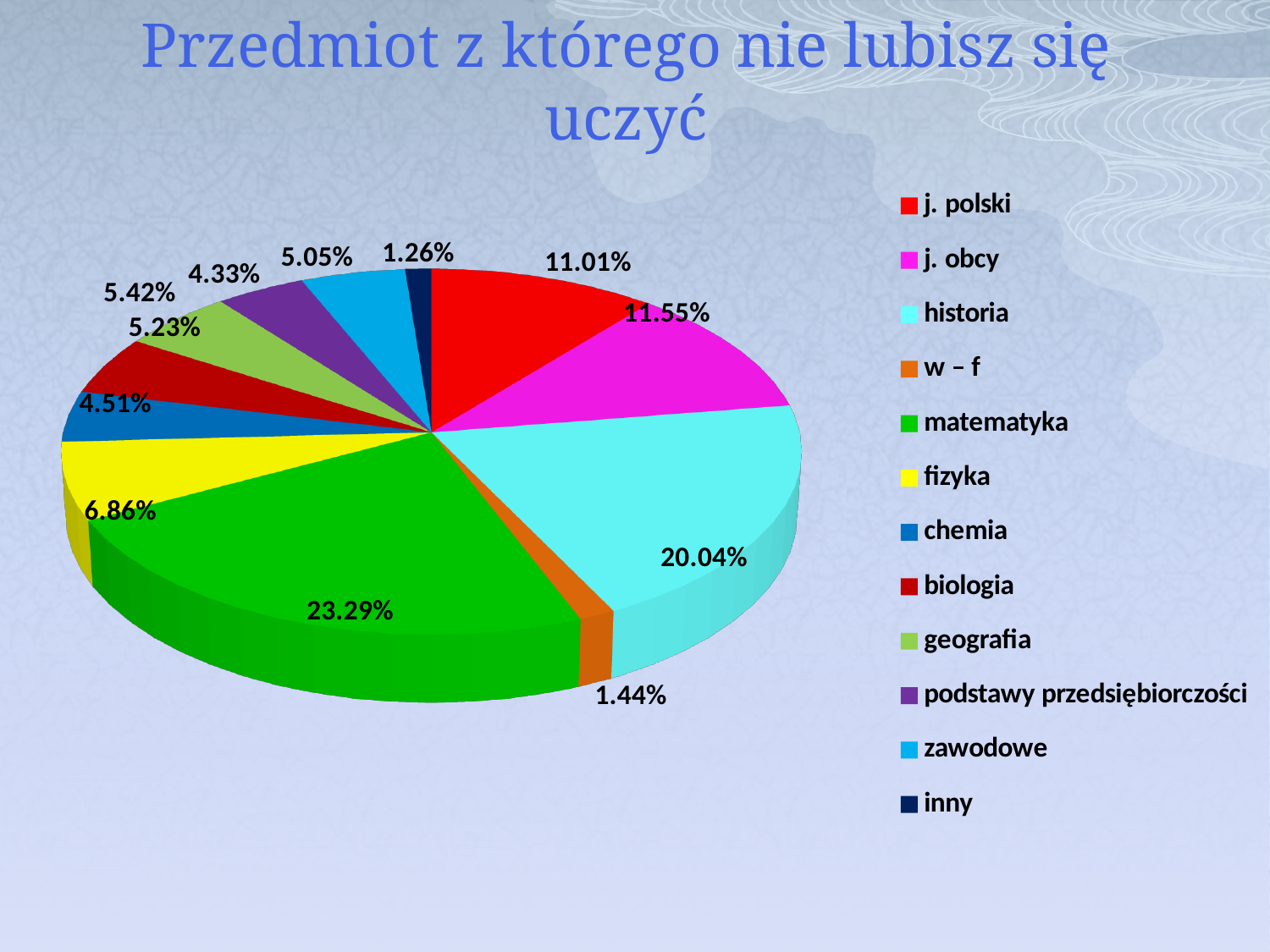
What is the value for j. obcy? 11.55% What is the title of the chart? Przedmiot z którego nie lubisz się uczyć What share of the pie does historia have? 20.04% What kind of chart is shown on the slide? pie chart What colour is the slice for zawodowe? light blue What is the difference between the shares for matematyka and historia? 3.25% Which is larger, the share for fizyka or the share for chemia? fizyka Which category has the largest share of the pie? matematyka What is the value for w – f? 1.44% What share of the pie does matematyka have? 23.29% How many categories does the legend list? 12 Which category has the smallest share of the pie? inny